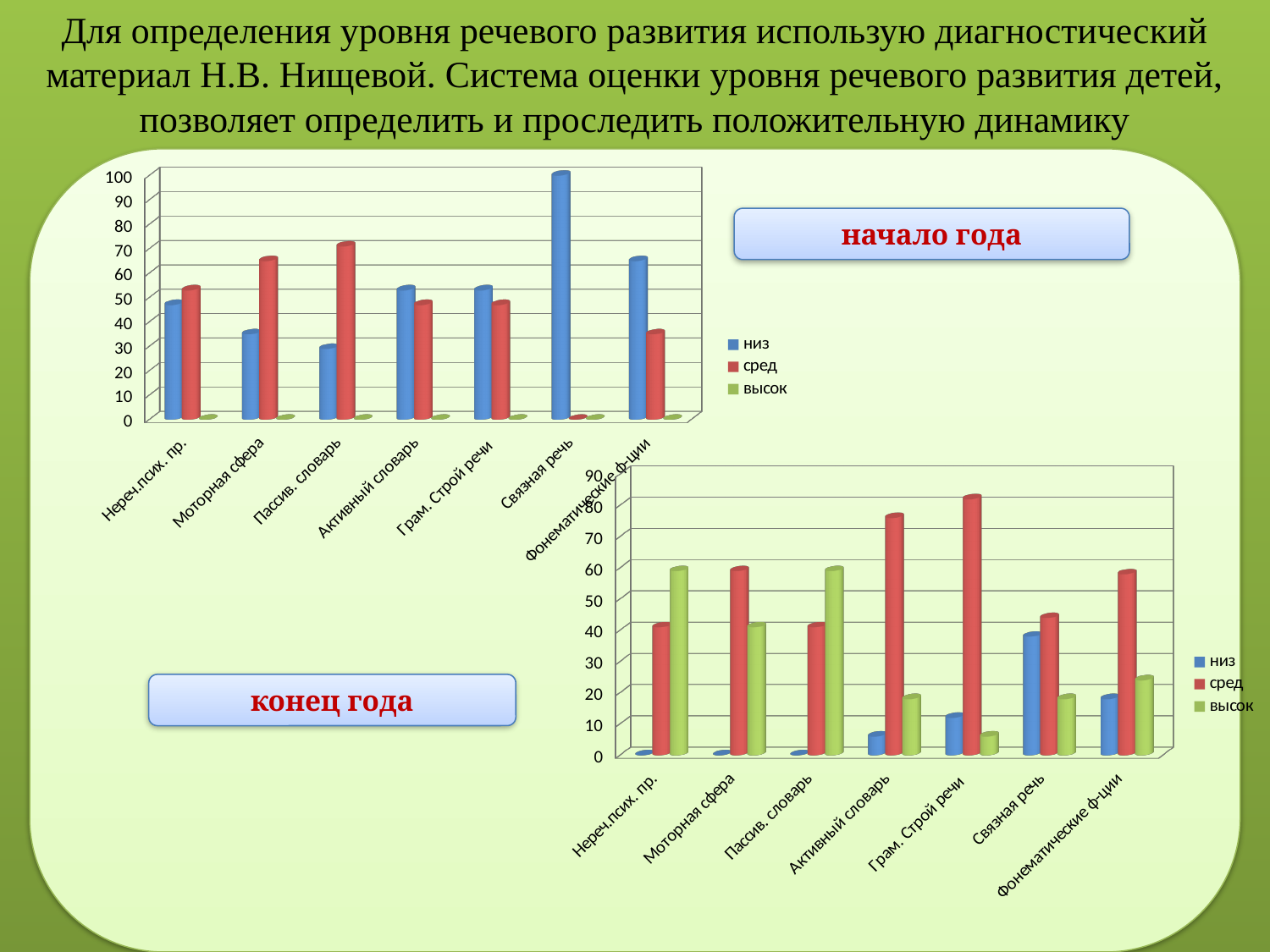
In the "конец года" chart, which category has the highest "сред" value? Грам. Строй речи How many series does the legend of the "конец года" chart list? 3 In the "конец года" chart, which is larger for "Активный словарь": "сред" or "высок"? сред How many categories are shown on the x axis of the "начало года" chart? 7 Which series is shown in green in the legend of the "начало года" chart? высок In the "конец года" chart, which category has the highest "низ" value? Связная речь In the "конец года" chart, is the value of "высок" for "Нереч.псих. пр." greater or less than 50? greater In the "начало года" chart, what is the value of "низ" for "Связная речь"? 100 In the "начало года" chart, which category has the highest "низ" value? Связная речь What kind of chart is the "начало года" chart? bar chart In the "начало года" chart, is the value of "сред" for "Моторная сфера" greater or less than 60? greater